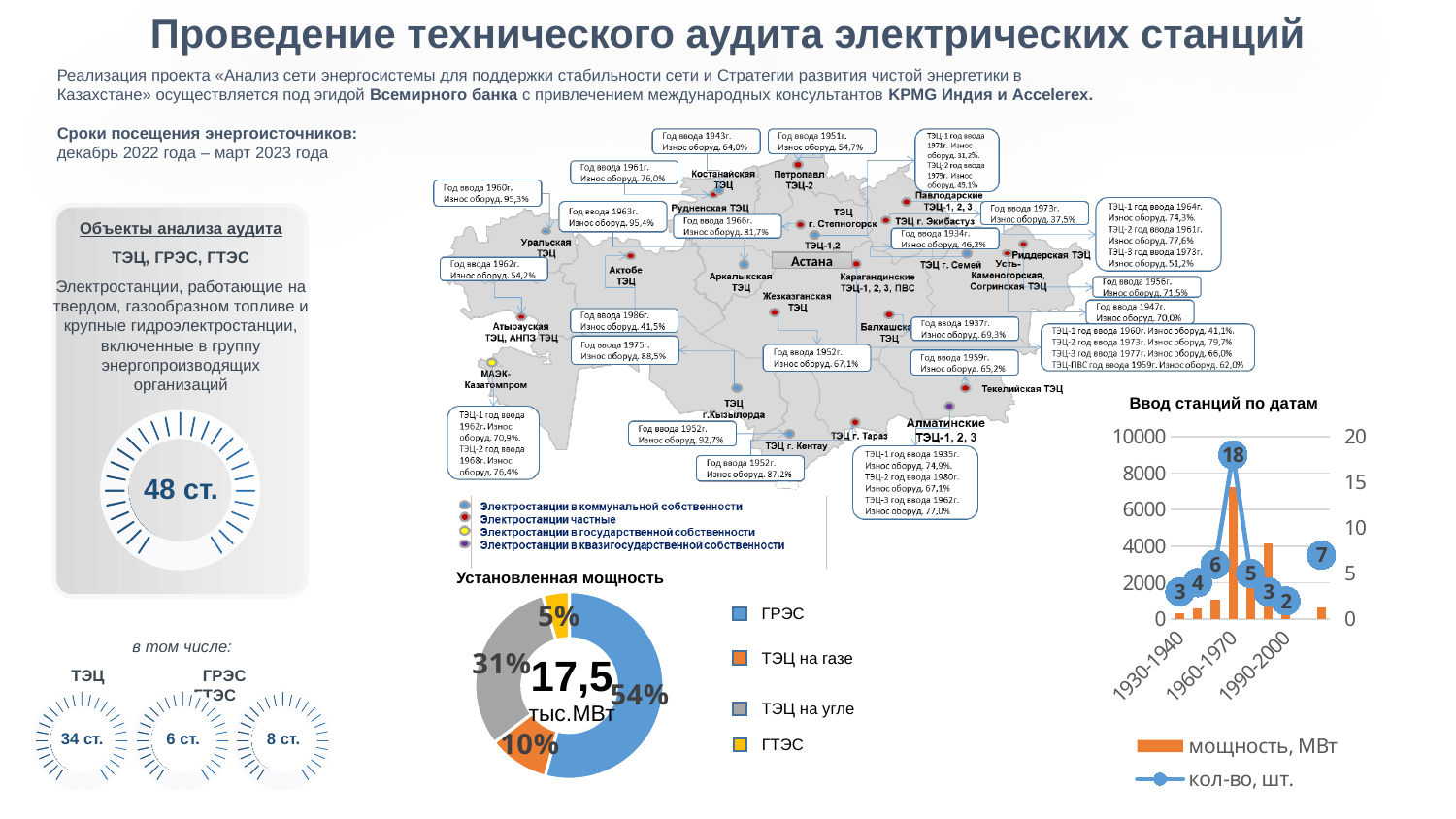
In the 'Установленная мощность' donut chart, what share does ГТЭС have? 5% How many series does the legend of the 'Ввод станций по датам' chart list? 2 In the 'Установленная мощность' donut chart, which category has the largest share? ГРЭС In the 'Установленная мощность' donut chart, what share does ТЭЦ на газе have? 10% In the 'Установленная мощность' donut chart, which category has the smallest share? ГТЭС In the 'Ввод станций по датам' chart, what is the highest value labelled on the 'кол-во, шт.' line? 18 In the 'Установленная мощность' donut chart, what share does ГРЭС have? 54% What total value is printed in the centre of the 'Установленная мощность' donut chart? 17,5 тыс.МВт In the 'Ввод станций по датам' chart, what is the lowest value labelled on the 'кол-во, шт.' line? 2 In the 'Установленная мощность' donut chart, how many categories does the legend list? 4 In the 'Установленная мощность' donut chart, what is the difference in percentage points between the ГРЭС share and the ТЭЦ на угле share? 23 percentage points